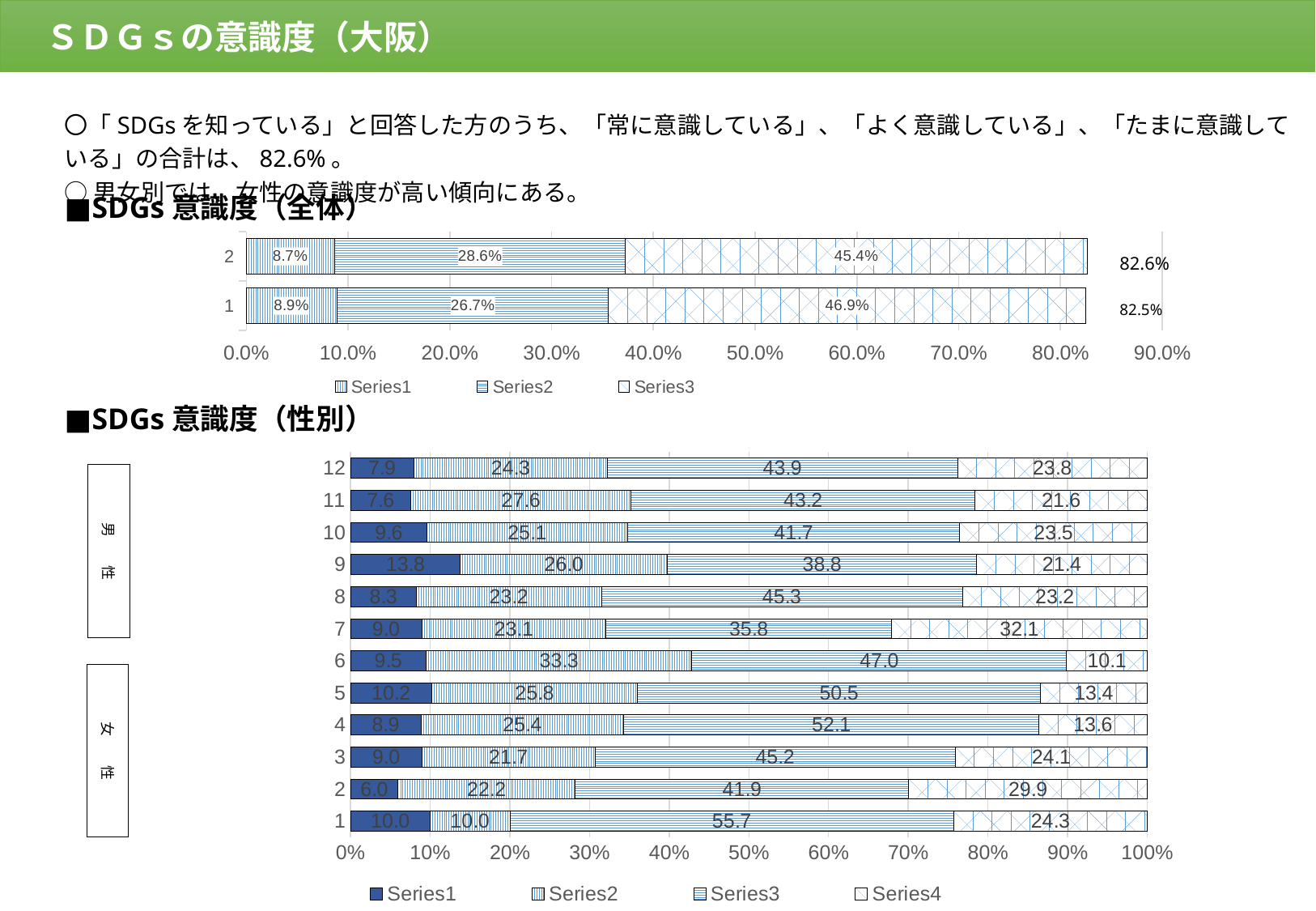
In the top chart (SDGs 意識度（全体）), how many series does the legend list? 3 In the bottom chart (SDGs 意識度（性別）), how many series does the legend list? 4 In the bottom chart (SDGs 意識度（性別）), what is the Series1 value for category 9? 13.8 In the bottom chart (SDGs 意識度（性別）), what is the Series3 value for category 1? 55.7 In the top chart (SDGs 意識度（全体）), what is the Series3 value for category 1? 46.9% In the bottom chart (SDGs 意識度（性別）), is the Series3 value for category 4 larger or smaller than that for category 7? Larger In the top chart (SDGs 意識度（全体）), what is the difference between the Series3 values for category 1 and category 2? 1.5% In the bottom chart (SDGs 意識度（性別）), which category has the lowest Series4 value? 6 In the top chart (SDGs 意識度（全体）), what is the Series2 value for category 2? 28.6% What kind of chart is the bottom chart (SDGs 意識度（性別）)? Stacked bar chart In the bottom chart (SDGs 意識度（性別）), how many categories are plotted? 12 In the bottom chart (SDGs 意識度（性別）), which category has the highest Series1 value? 9